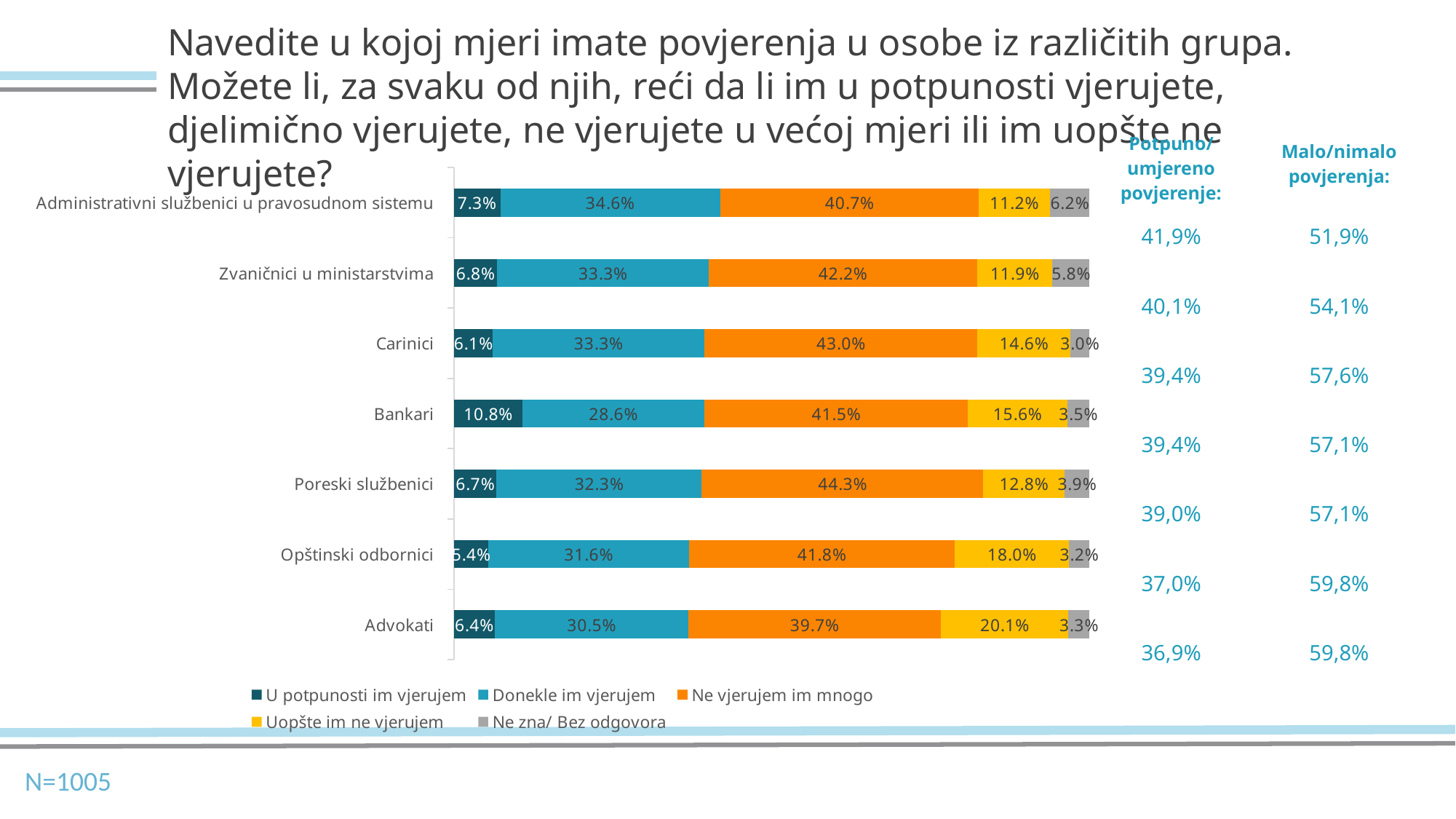
Which group has the highest "Uopšte im ne vjerujem" share? Advokati What percentage of respondents answered "U potpunosti im vjerujem" for Bankari? 10.8% How many groups (categories) are shown in the chart? 7 How many series does the legend list? 5 Which has a larger "Ne vjerujem im mnogo" share: Poreski službenici or Carinici? Poreski službenici What colour represents the "Ne vjerujem im mnogo" series in the legend? Orange Which group has the lowest "Ne zna/ Bez odgovora" share? Carinici What type of chart is shown on the slide? Stacked bar chart Which group has the highest "U potpunosti im vjerujem" share? Bankari What is the difference between the "Donekle im vjerujem" values for Administrativni službenici u pravosudnom sistemu and Advokati? 4.1 percentage points What is the combined "U potpunosti im vjerujem" and "Donekle im vjerujem" share for Bankari? 39.4% What is the "Uopšte im ne vjerujem" value for Advokati? 20.1%